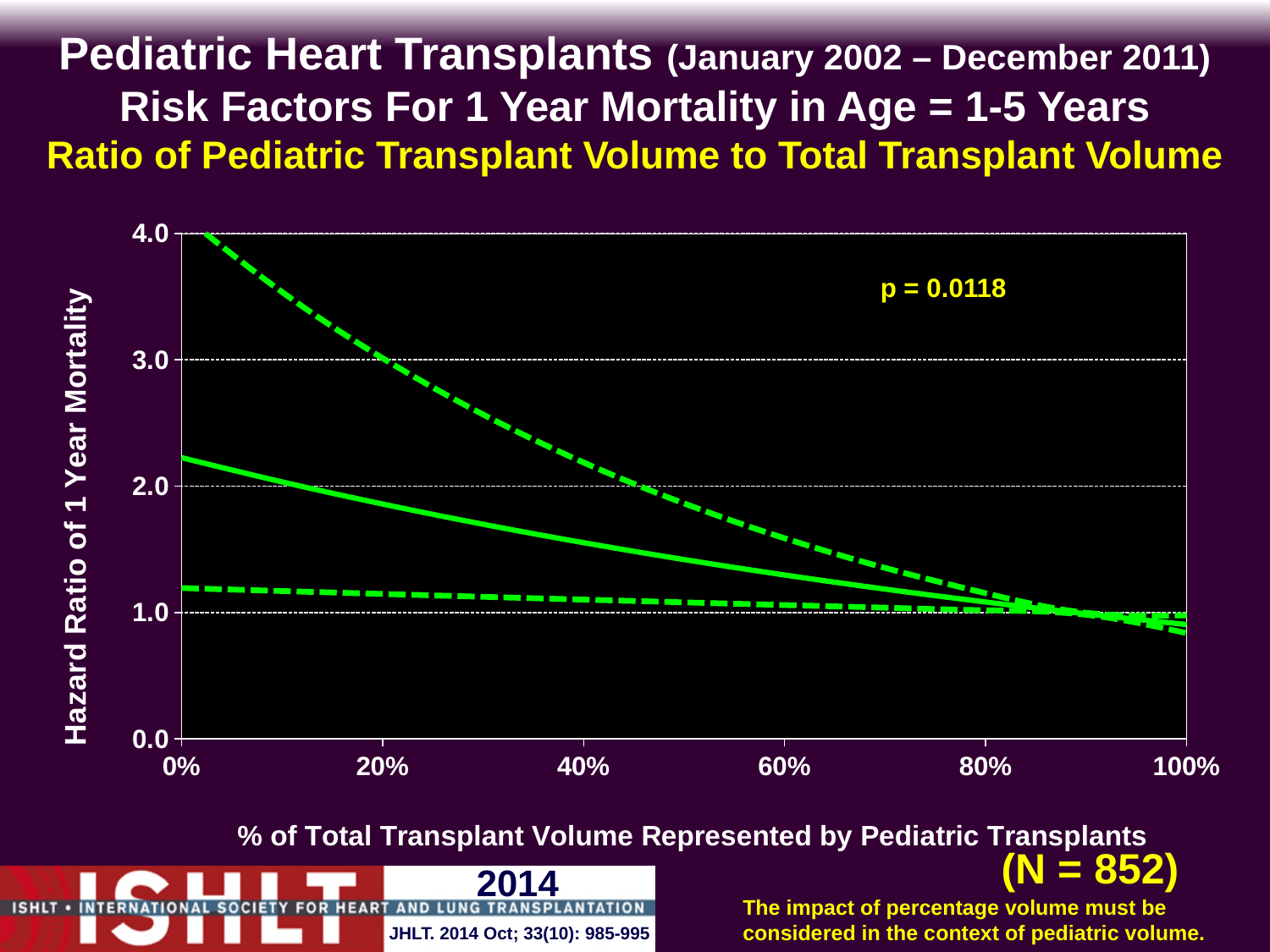
What kind of chart is shown on the slide? line chart Is the value of the lower dashed line at 0% greater or less than 2.0? less Is the value of the solid line at 60% greater or less than 2.0? less What is the p-value shown on the chart? p = 0.0118 Is the value of the upper dashed line at 60% greater or less than 2.0? less How many lines are plotted on the chart? 3 At 20%, which line has the higher value: the upper dashed line or the solid line? the upper dashed line Does the upper dashed line rise or fall along the x axis from 0% to 100%? fall What is the label of the y axis? Hazard Ratio of 1 Year Mortality Does the solid line rise or fall as the percentage of total transplant volume represented by pediatric transplants increases? fall